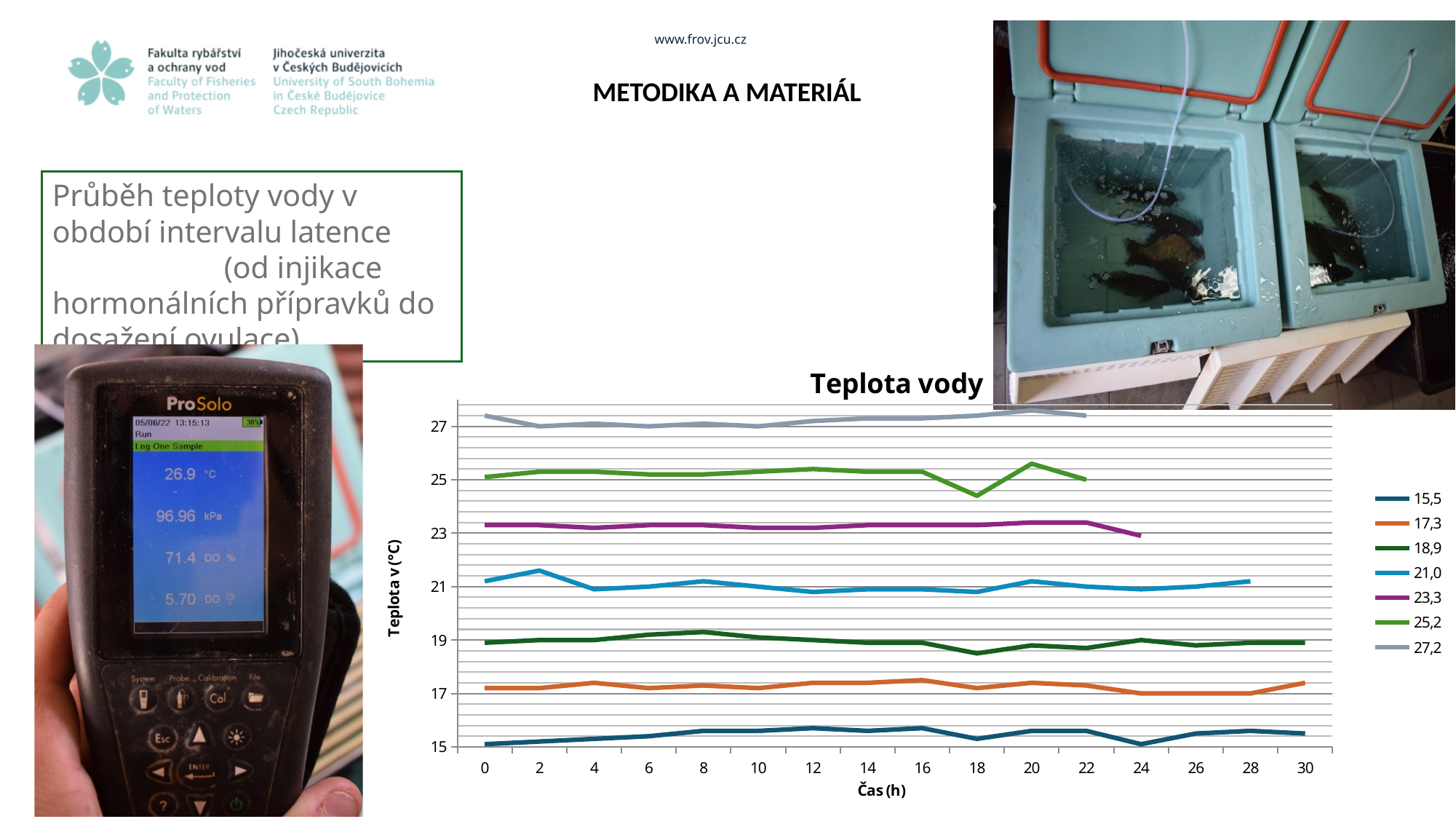
In the "Teplota vody" chart, is the value of the 18,9 series at 18 h greater or less than 19? less How many series does the legend of the "Teplota vody" chart list? 7 In the "Teplota vody" chart, is the value of the 25,2 series at 18 h greater or less than 25? less What is the label of the x axis of the "Teplota vody" chart? Čas (h) Which series in the "Teplota vody" chart has the highest values throughout? 27,2 What kind of chart is shown under the title "Teplota vody"? line chart In the "Teplota vody" chart, is the value of the 27,2 series at 0 h greater or less than 27? greater In the "Teplota vody" chart, which series has the larger value at 20 h: 25,2 or 23,3? 25,2 Which series in the "Teplota vody" chart has the lowest values throughout? 15,5 In the "Teplota vody" chart, at what time (h) does the 23,3 series end? 24 What is the title of the chart on the slide? Teplota vody